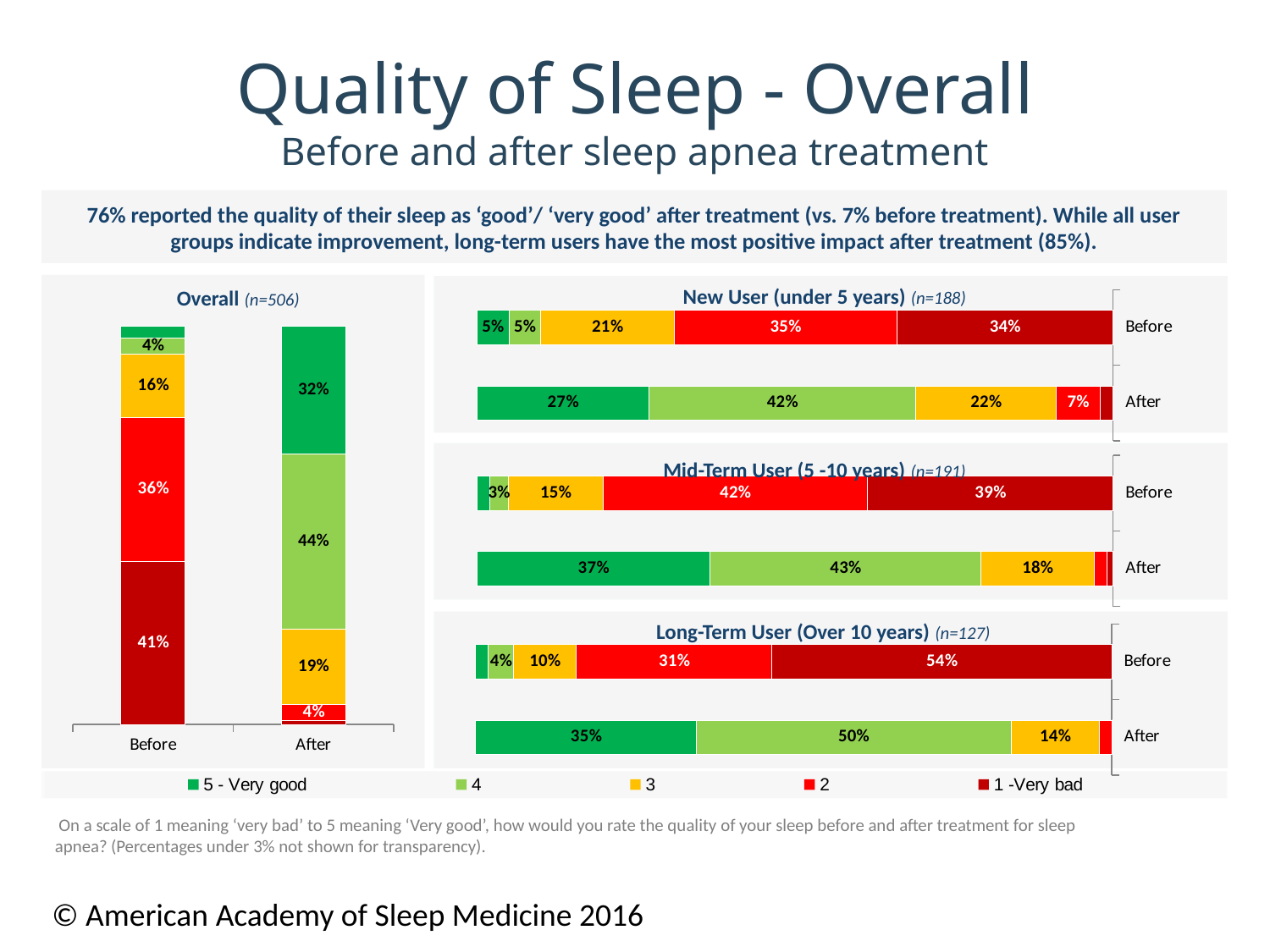
In the New User (under 5 years) chart, what is the difference between the '4' share after treatment and the '4' share before treatment? 37% What is the sample size (n) shown for the Mid-Term User (5-10 years) chart? 191 In the Mid-Term User (5-10 years) chart, which is larger: the '3' share before treatment or the '3' share after treatment? After treatment (18%) In the New User (under 5 years) chart, what percentage rated their sleep quality as '2' before treatment? 35% In the Overall chart, what percentage rated their sleep quality as '4' after treatment? 44% How many series does the legend list? 5 What type of chart is the Overall chart? Stacked bar chart In the Overall chart, what percentage rated their sleep quality as '1 - Very bad' before treatment? 41% In the Long-Term User (Over 10 years) chart, what percentage rated their sleep quality as '1 - Very bad' before treatment? 54% In the Long-Term User (Over 10 years) chart, which rating category has the largest share after treatment? 4 In the Overall chart, which labeled rating category has the smallest share after treatment? 2 In the Mid-Term User (5-10 years) chart, what percentage rated their sleep quality as '5 - Very good' after treatment? 37%